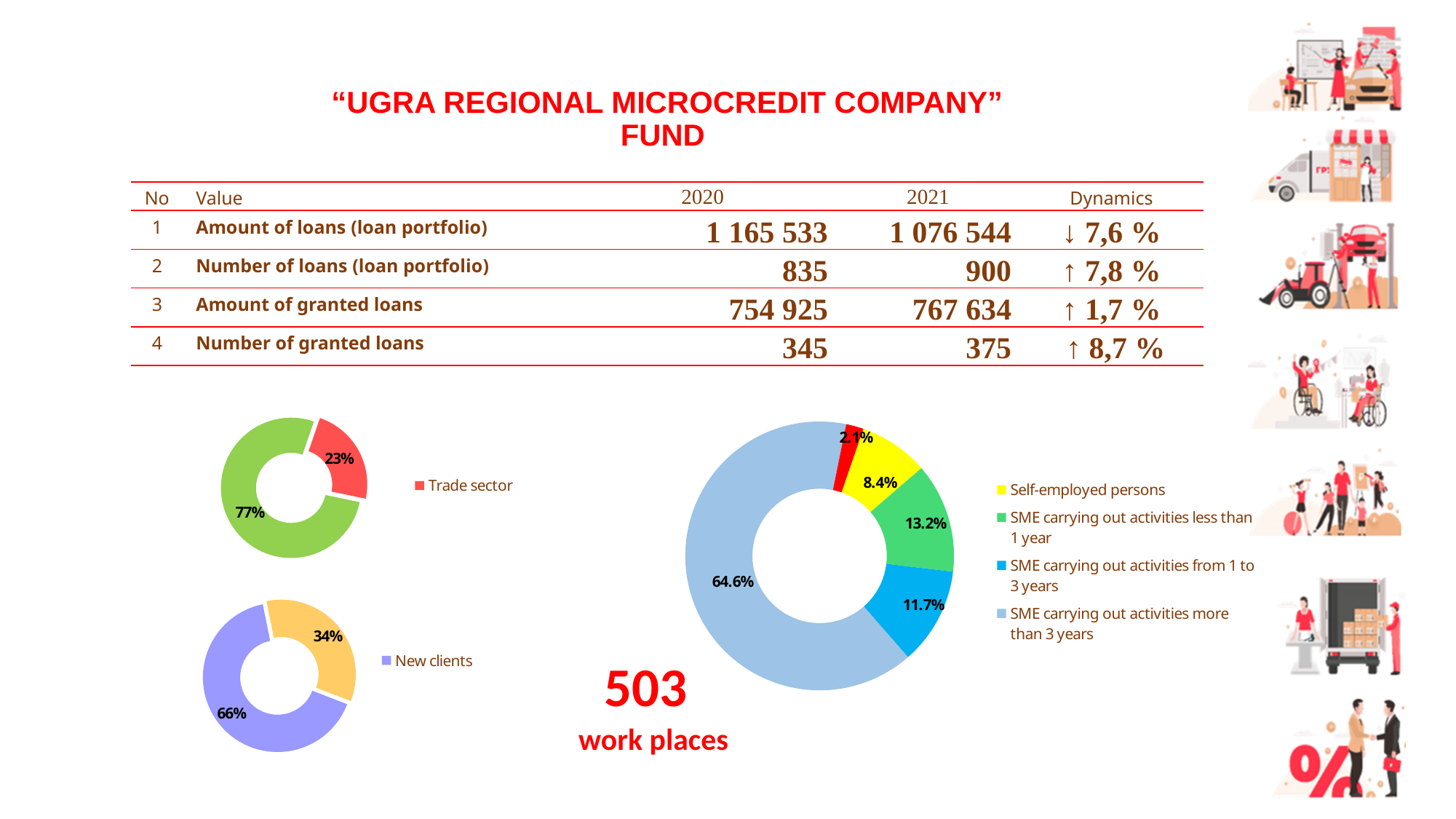
In the top-left donut chart, what share is shown for Trade sector? 23% In the large donut chart in the centre of the slide, what share is shown for Self-employed persons? 8.4% How many entries does the legend of the large donut chart in the centre of the slide list? 4 In the bottom-left donut chart, what colour is the New clients slice? Purple In the large donut chart in the centre of the slide, which legend category has the largest share? SME carrying out activities more than 3 years In the large donut chart in the centre of the slide, what share is shown for SME carrying out activities more than 3 years? 64.6% In the large donut chart in the centre of the slide, what is the difference in percentage points between the share for SME carrying out activities less than 1 year and the share for Self-employed persons? 4.8 What kind of chart is the top-left chart with the Trade sector legend? Donut (pie) chart In the large donut chart in the centre of the slide, which is larger: the share for SME carrying out activities less than 1 year or the share for SME carrying out activities from 1 to 3 years? SME carrying out activities less than 1 year In the bottom-left donut chart, what share is shown for New clients? 66% In the large donut chart in the centre of the slide, what share is shown for SME carrying out activities from 1 to 3 years? 11.7% In the large donut chart in the centre of the slide, what share is shown for SME carrying out activities less than 1 year? 13.2%